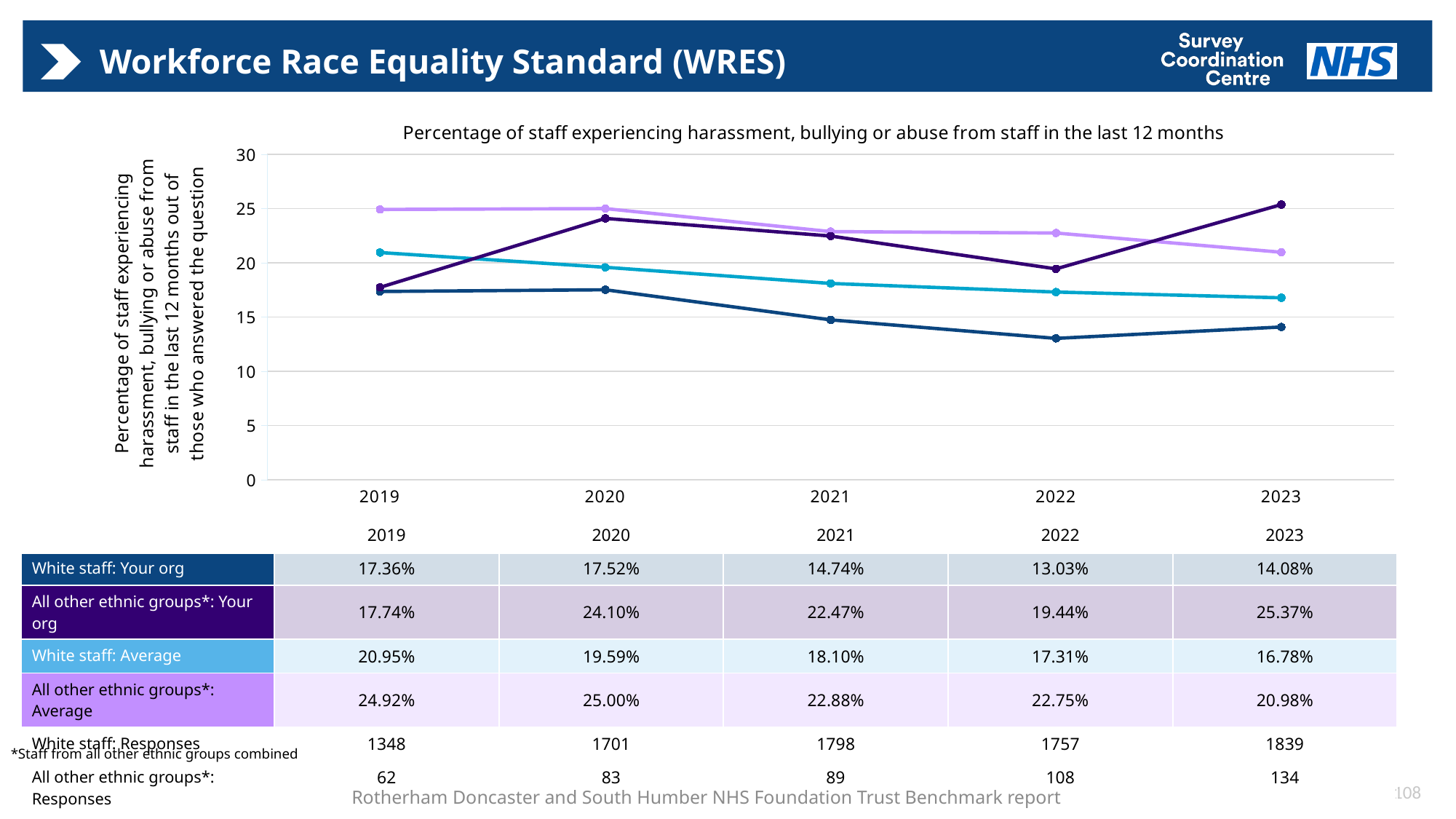
In which year is the value for All other ethnic groups*: Your org highest? 2023 What is the value for All other ethnic groups*: Your org in 2023? 25.37% How many series are plotted on the chart? 4 Does the value for White staff: Average rise or fall from 2019 to 2023? fall What is the difference between All other ethnic groups*: Your org and White staff: Your org in 2023? 11.29 percentage points In 2020, which is larger: White staff: Average or All other ethnic groups*: Average? All other ethnic groups*: Average How many years are plotted on the x axis? 5 In which year is the value for White staff: Your org lowest? 2022 Is the value for White staff: Your org in 2021 greater or less than 15? less What is the value for White staff: Average in 2019? 20.95% What is the value for White staff: Your org in 2022? 13.03% What kind of chart is shown on the slide? line chart